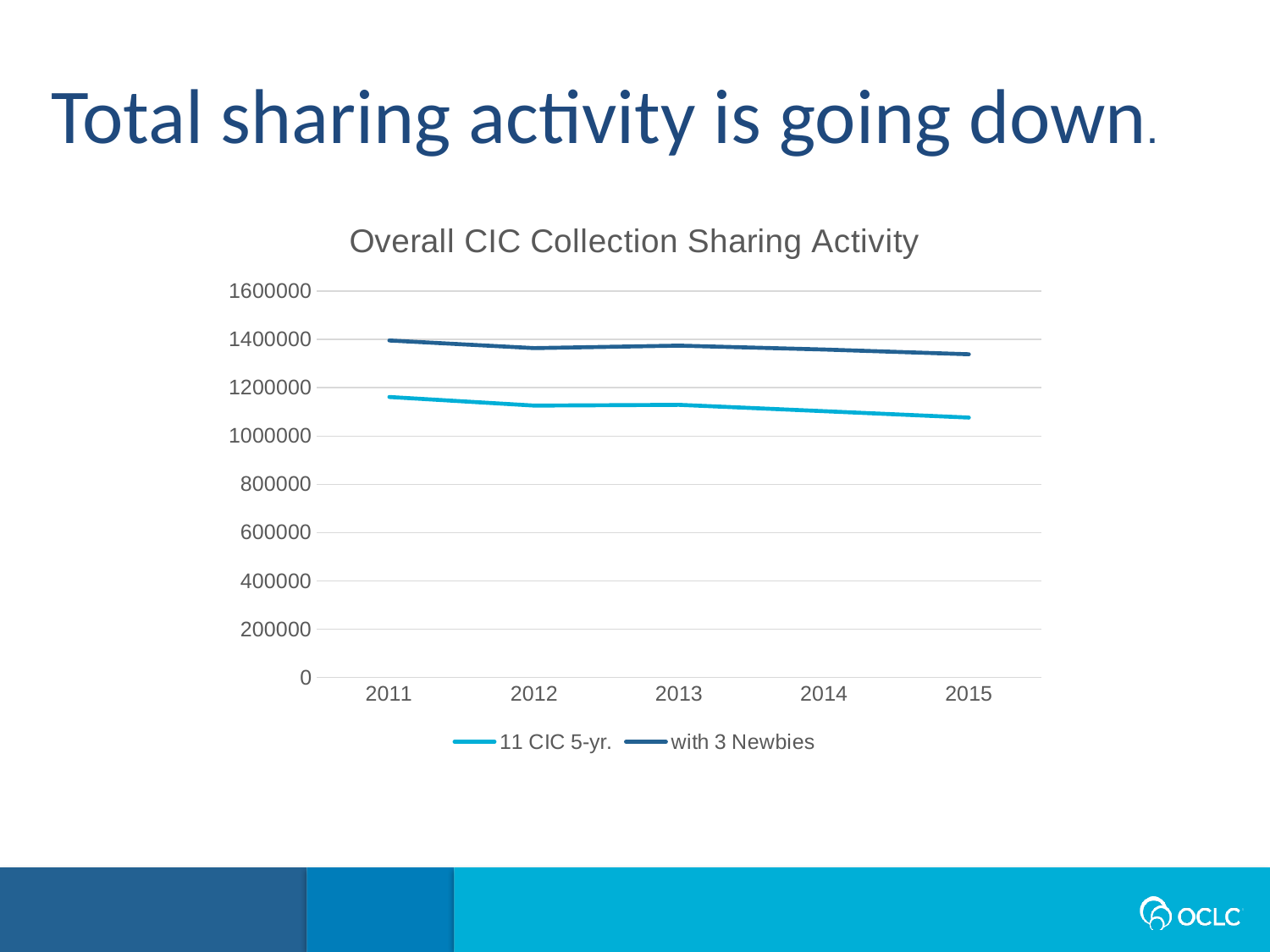
What type of chart is shown on the slide? line chart Is the value for 11 CIC 5-yr. in 2015 greater or less than 1000000? greater Is the value for with 3 Newbies in 2011 greater or less than 1200000? greater Is the value for with 3 Newbies in 2015 greater or less than 1400000? less In which year is the 11 CIC 5-yr. series at its lowest? 2015 How many years are shown on the x axis? 5 Which series has the higher value in 2013, 11 CIC 5-yr. or with 3 Newbies? with 3 Newbies How many series does the legend list? 2 What is the title of the chart? Overall CIC Collection Sharing Activity In which year is the 11 CIC 5-yr. series at its highest? 2011 What are the names of the two series in the legend? 11 CIC 5-yr. and with 3 Newbies